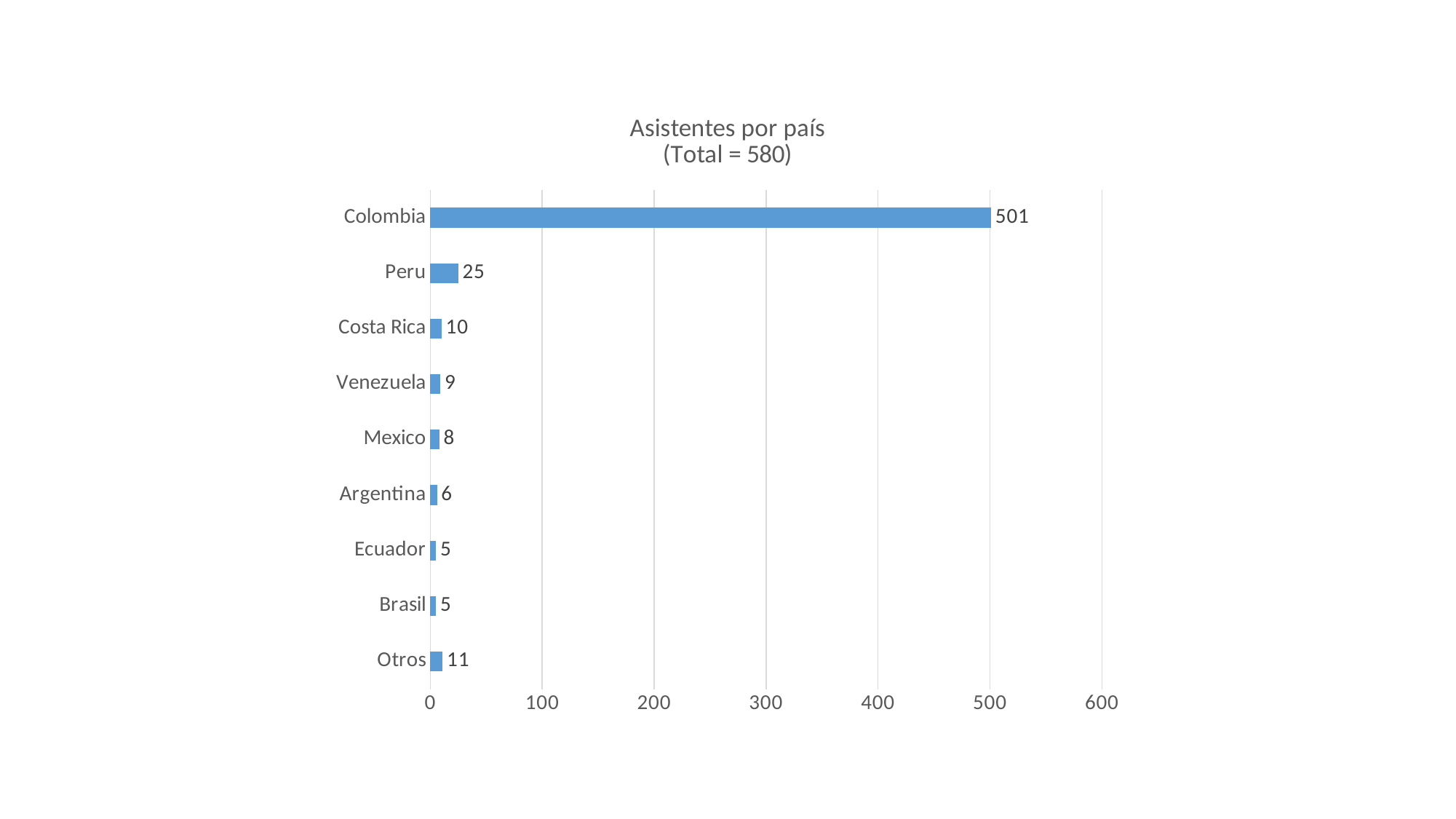
Which is larger, the value for Mexico or the value for Ecuador? Mexico What is the difference between the values for Costa Rica and Argentina? 4 What is the value for Colombia? 501 What is the difference between the values for Colombia and Peru? 476 Is the value for Colombia greater or less than 400? greater Which country has the highest number of attendees? Colombia What kind of chart is shown on the slide? Bar chart What is the value for Peru? 25 What is the value for Otros? 11 What is the title of the chart? Asistentes por país (Total = 580) How many categories are shown on the chart? 9 What is the value for Venezuela? 9